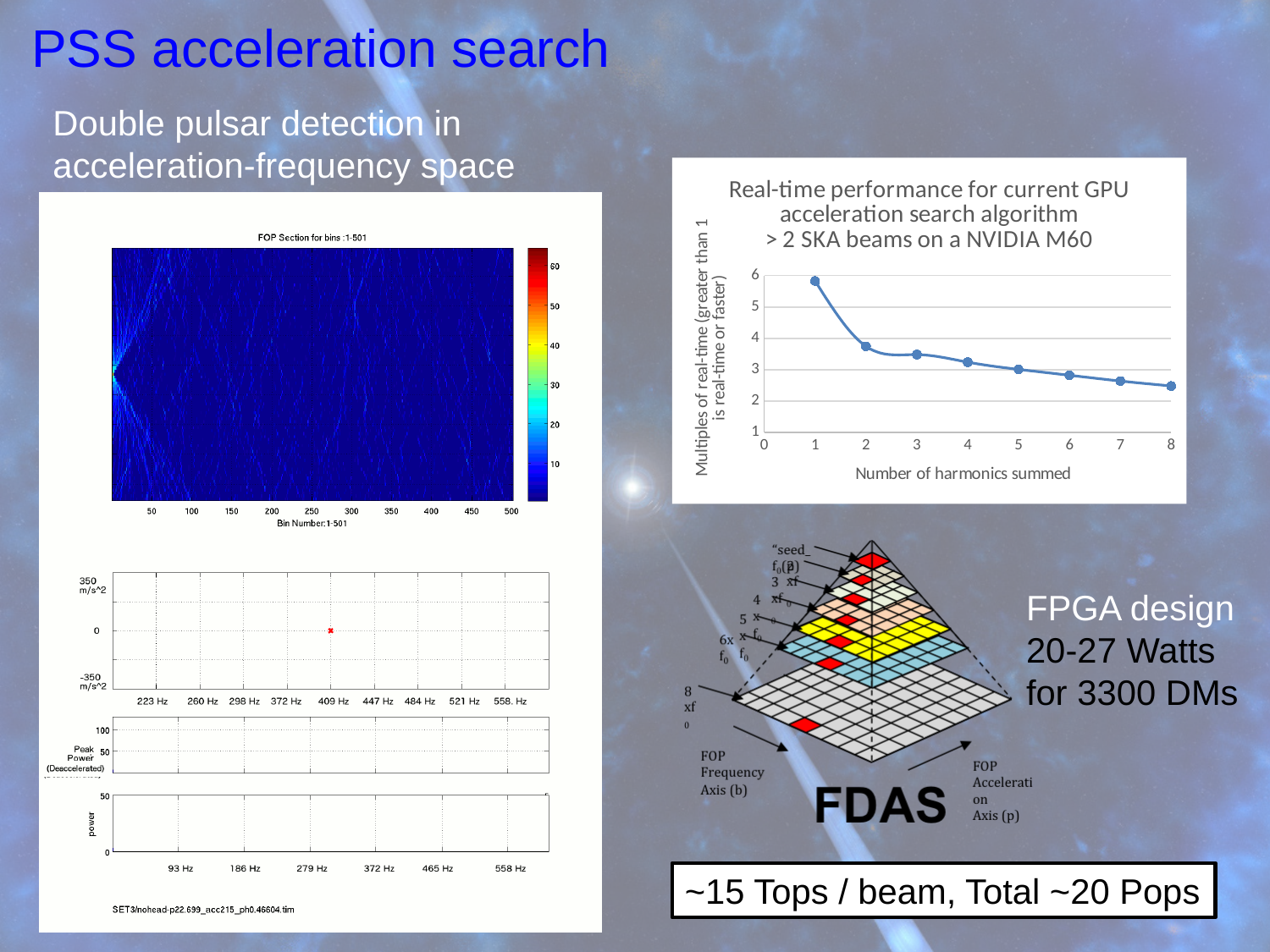
In the 'Real-time performance' line chart, is the value for 8 harmonics summed greater or less than 3? less In the 'Real-time performance' line chart, which has the larger value: 1 harmonic summed or 3 harmonics summed? 1 harmonic summed In the 'Real-time performance' line chart, do the values rise or fall as the number of harmonics summed increases? fall How many data points are plotted in the 'Real-time performance' line chart? 8 In the 'Real-time performance' line chart, which has the larger value: 2 harmonics summed or 7 harmonics summed? 2 harmonics summed In the 'Real-time performance' line chart, is the value for 2 harmonics summed greater or less than 4? less What is the x-axis title of the 'Real-time performance' line chart? Number of harmonics summed In the 'Real-time performance' line chart, is the value for 5 harmonics summed greater or less than 2? greater In the 'Real-time performance' line chart, at which number of harmonics summed is the multiple of real-time lowest? 8 In the 'Real-time performance' line chart, at which number of harmonics summed is the multiple of real-time highest? 1 What kind of chart is the 'Real-time performance for current GPU acceleration search algorithm' chart? line chart